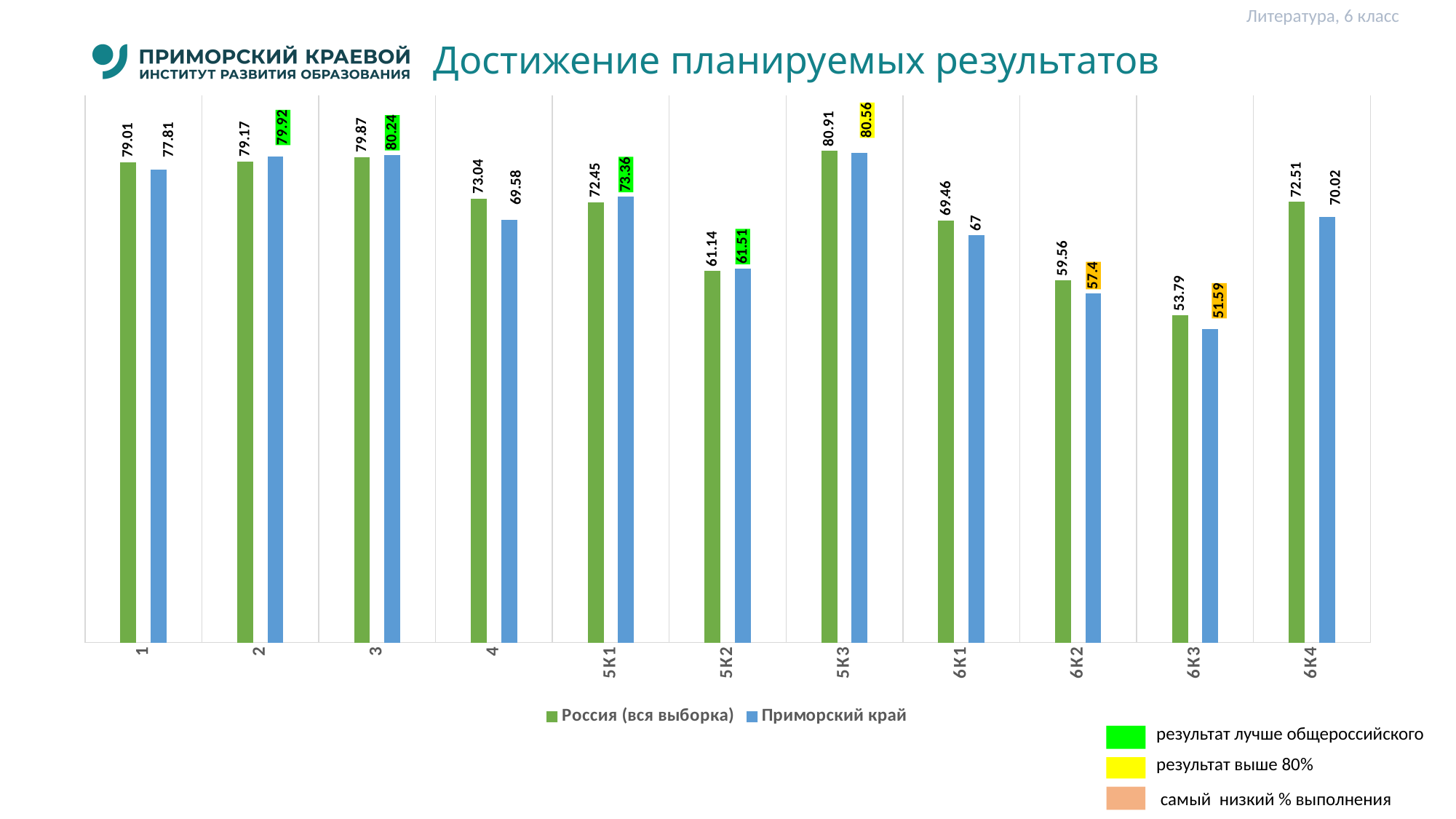
What is the value for Россия (вся выборка) for category 6К3? 53.79 What is the value for Приморский край for category 5К3? 80.56 What is the value for Приморский край for category 6К1? 67 What kind of chart is shown on the slide? bar chart What is the title of the chart? Достижение планируемых результатов How many categories are shown on the x axis? 11 How many series does the legend list? 2 Which colour represents the series Приморский край in the legend? blue For category 2, which series has the larger value: Россия (вся выборка) or Приморский край? Приморский край Which category has the highest value for Россия (вся выборка)? 5К3 What is the difference between Россия (вся выборка) and Приморский край for category 4? 3.46 Which category has the lowest value for Приморский край? 6К3